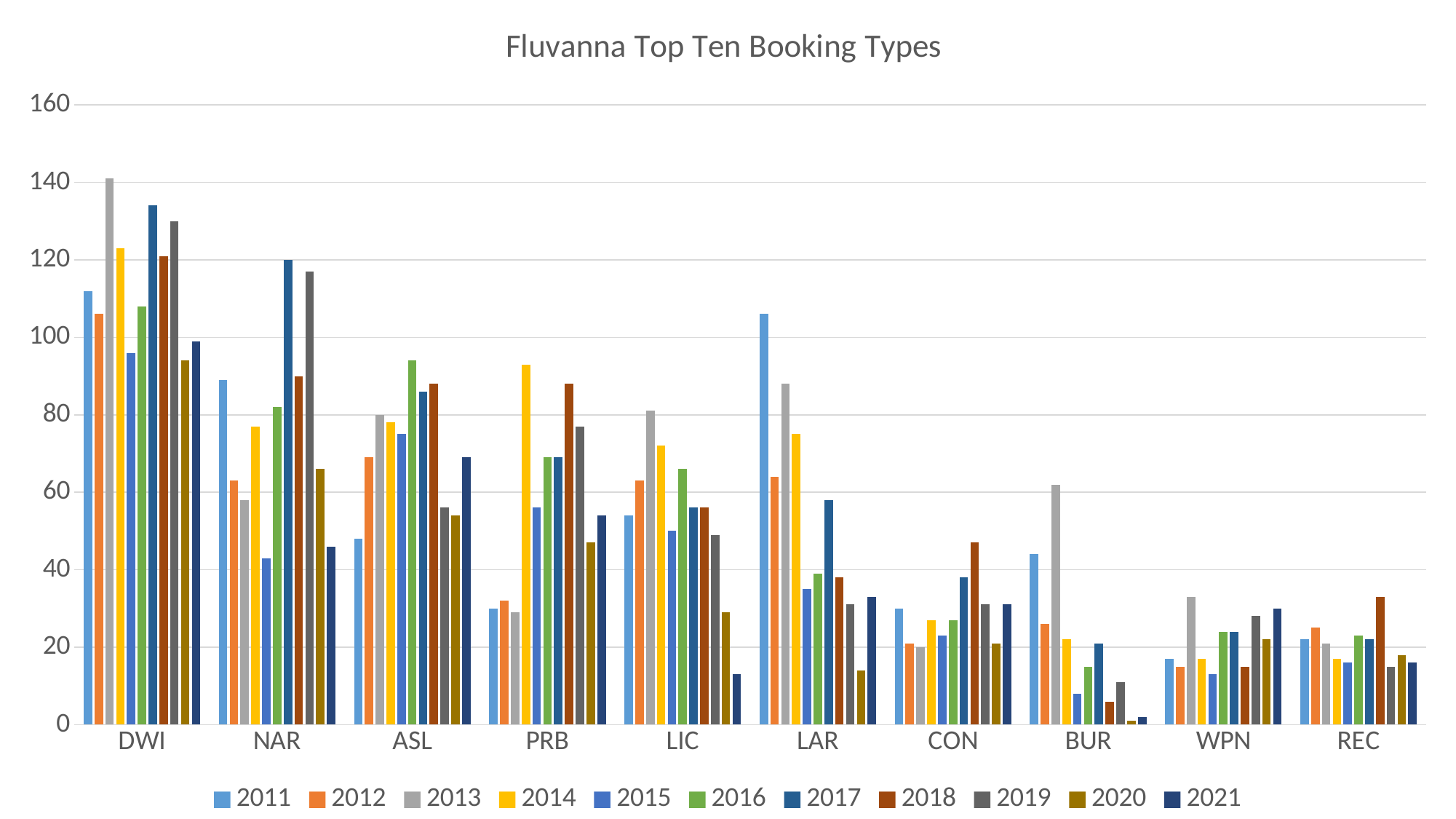
Is the value for NAR in 2017 greater or less than 100? greater What is the title of the chart? Fluvanna Top Ten Booking Types Is the value for BUR in 2013 greater or less than 40? greater How many booking type categories are shown on the x axis? 10 What kind of chart is shown on the slide? bar chart Is the value for PRB in 2014 greater or less than 80? greater Which year has the lowest value for BUR? 2020 Which booking type has the highest value for 2013? DWI How many series does the legend list? 11 Which year is shown in yellow in the legend? 2014